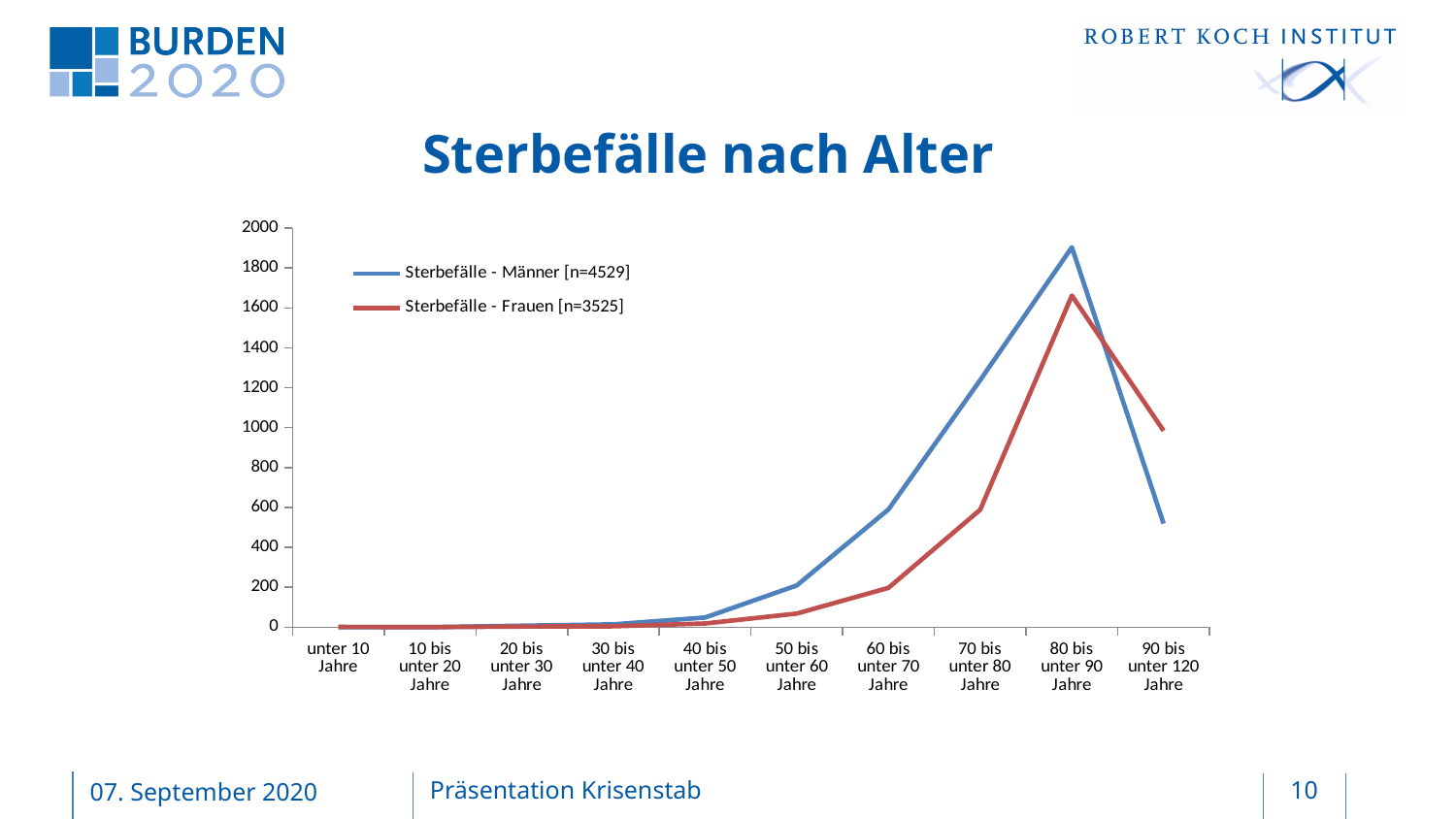
In the age group 90 bis unter 120 Jahre, which series has the higher value, Sterbefälle - Männer or Sterbefälle - Frauen? Sterbefälle - Frauen How many series does the legend list? 2 In the age group 70 bis unter 80 Jahre, which series has the higher value, Sterbefälle - Männer or Sterbefälle - Frauen? Sterbefälle - Männer Is the value for Sterbefälle - Frauen in the age group 80 bis unter 90 Jahre greater or less than 1800? less How many age groups are shown on the x axis? 10 What is the n value given in the legend for the series Sterbefälle - Männer? n=4529 Is the value for Sterbefälle - Männer in the age group 90 bis unter 120 Jahre greater or less than 800? less What kind of chart is shown on the slide? line chart Is the value for Sterbefälle - Männer in the age group 80 bis unter 90 Jahre greater or less than 1800? greater What is the title of the chart? Sterbefälle nach Alter In which age group does the series Sterbefälle - Männer reach its highest value? 80 bis unter 90 Jahre In which age group does the series Sterbefälle - Frauen reach its highest value? 80 bis unter 90 Jahre